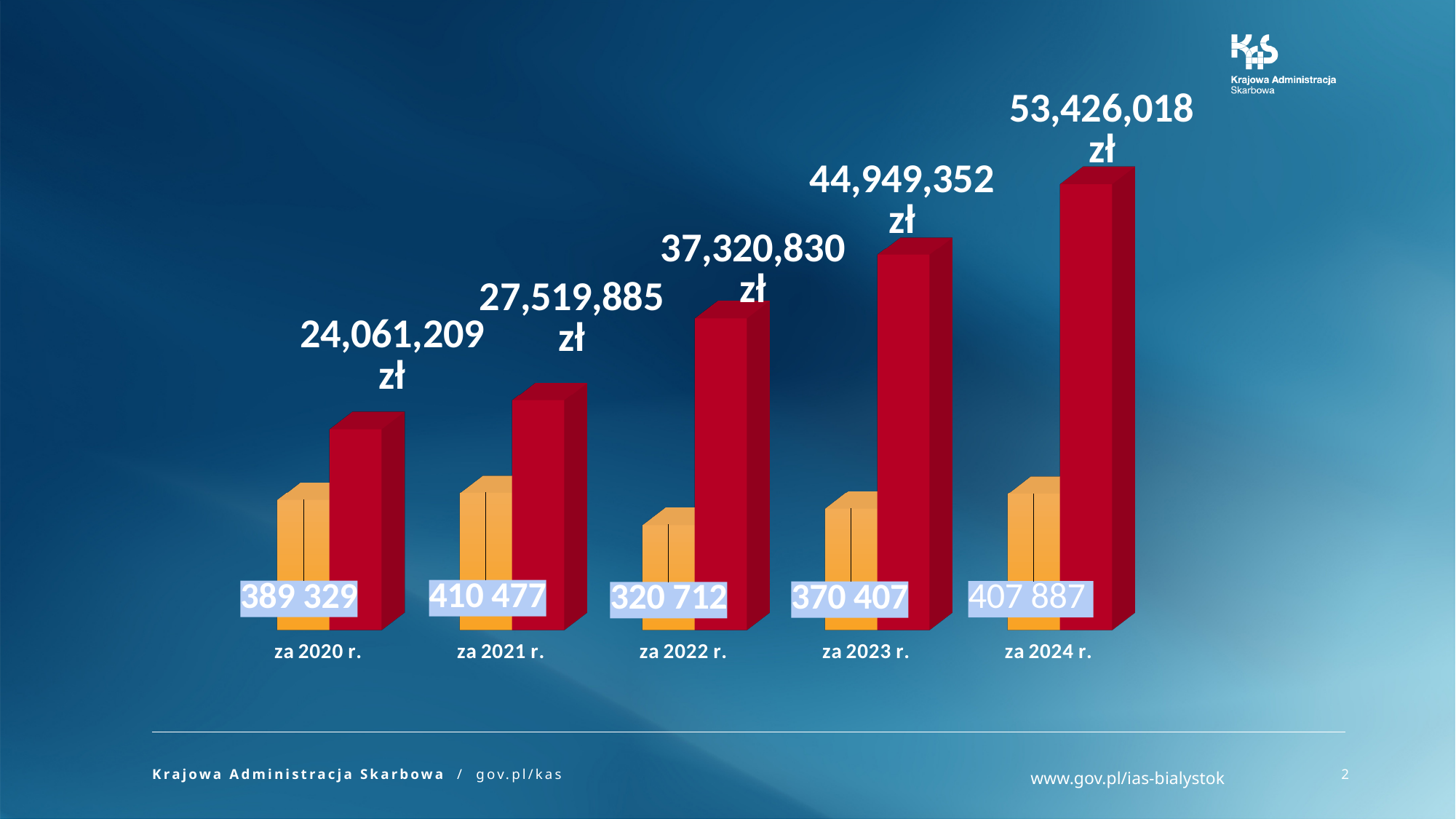
What is the value of the red bar for za 2020 r.? 24,061,209 zł What is the value of the orange bar for za 2022 r.? 320 712 What is the value of the orange bar for za 2023 r.? 370 407 How many years are shown on the chart? 5 Which year has the highest orange bar value? za 2021 r. What is the difference between the red bar values for za 2024 r. and za 2023 r.? 8,476,666 zł What is the value of the red bar for za 2024 r.? 53,426,018 zł Which is larger: the red bar value for za 2022 r. or for za 2021 r.? za 2022 r. Do the red bar values rise or fall from za 2020 r. to za 2024 r.? rise Which year has the lowest orange bar value? za 2022 r. Which year has the highest red bar value? za 2024 r. What is the difference between the orange bar values for za 2021 r. and za 2020 r.? 21 148